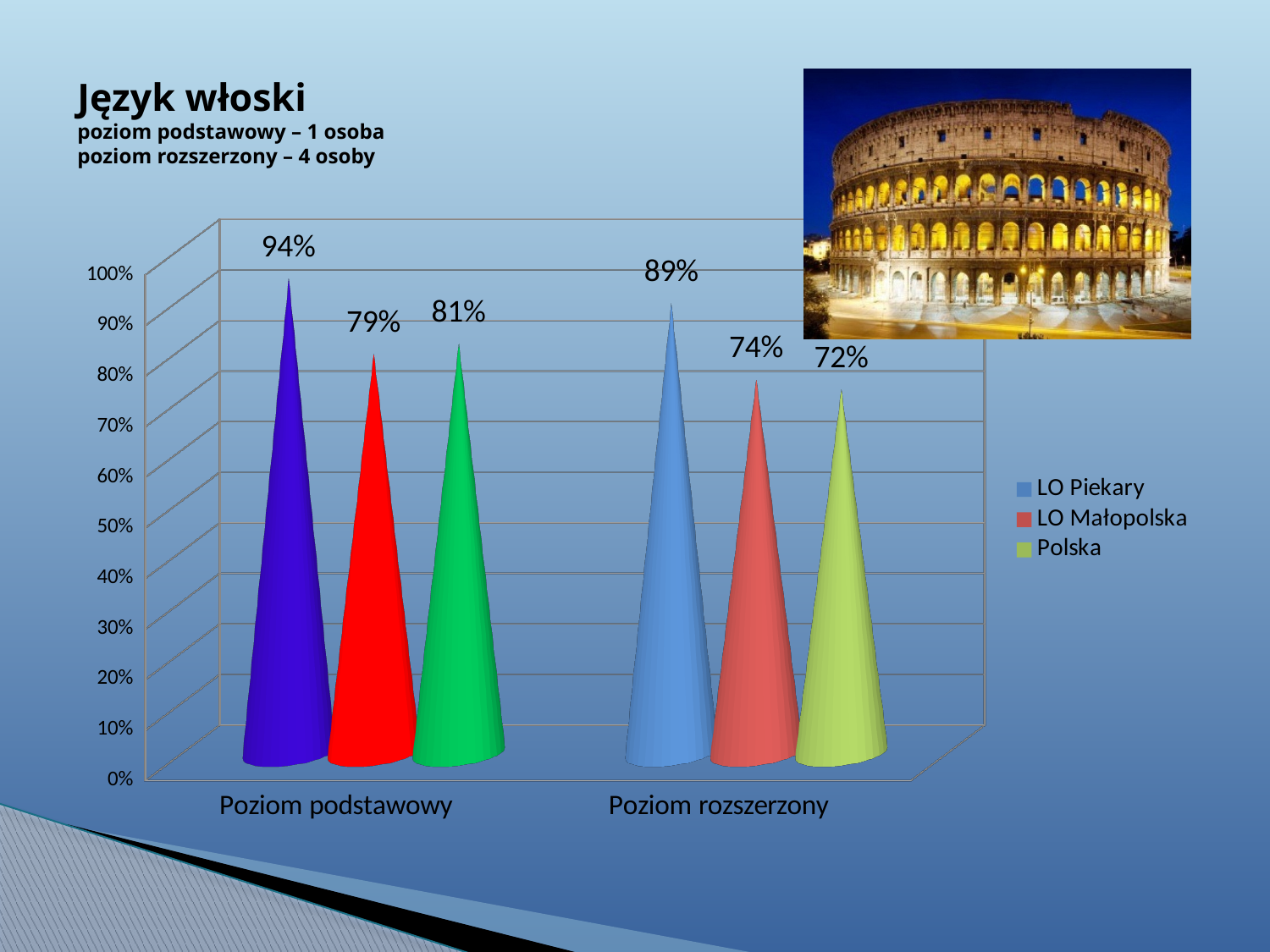
How many series does the legend list? 3 What is the value for Polska at Poziom podstawowy? 81% Which series has the highest value at Poziom rozszerzony? LO Piekary What kind of chart is shown on the slide? Bar chart Does the value for Polska rise or fall from Poziom podstawowy to Poziom rozszerzony? Fall What is the value for LO Piekary at Poziom rozszerzony? 89% Which series has the lowest value at Poziom podstawowy? LO Małopolska What is the value for LO Piekary at Poziom podstawowy? 94% Which is larger at Poziom podstawowy: LO Małopolska or Polska? Polska How many categories are shown on the x axis? 2 What is the value for LO Małopolska at Poziom rozszerzony? 74% What is the difference between LO Piekary and Polska at Poziom rozszerzony? 17%